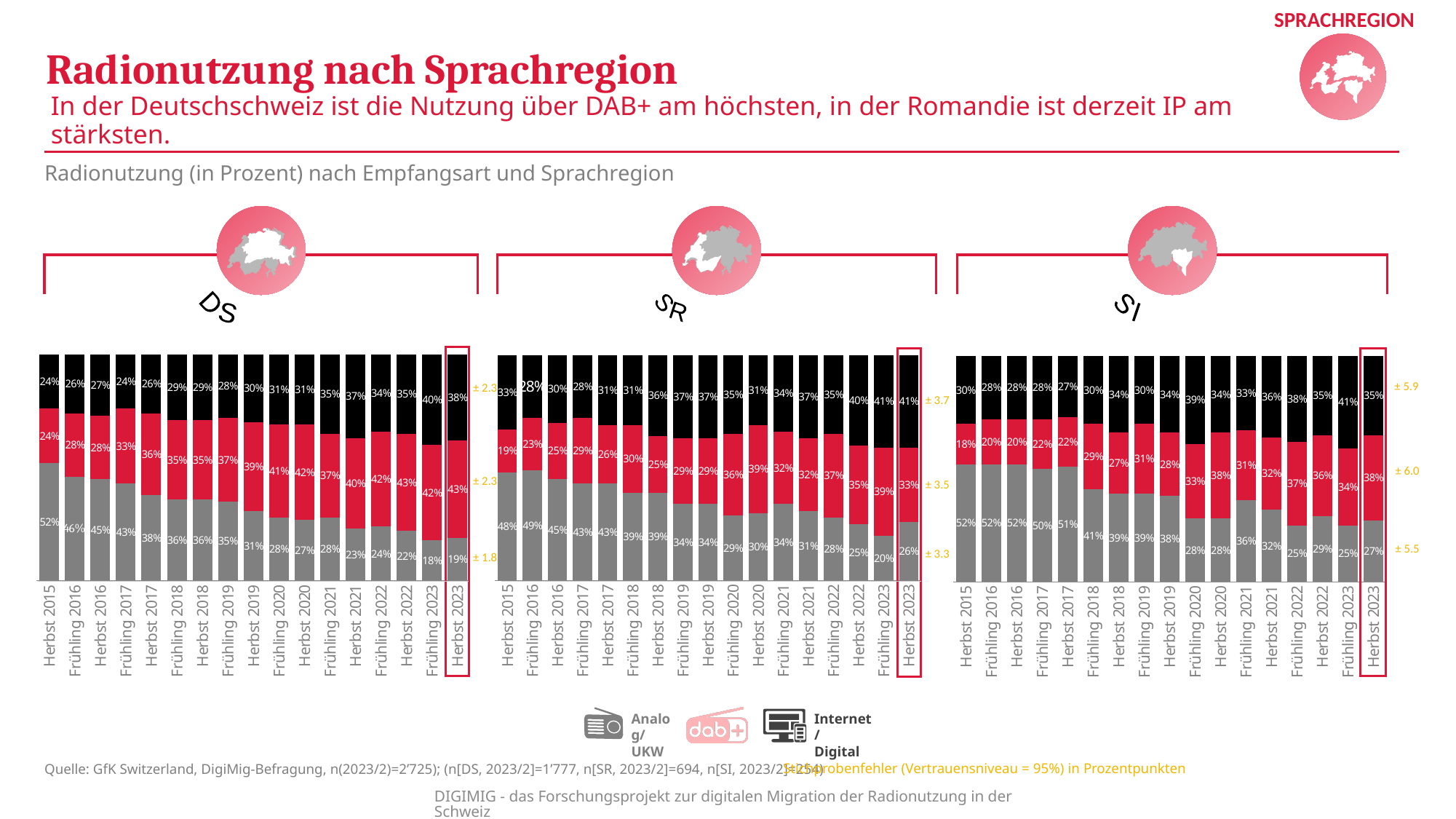
In the SR chart, what is the Internet/Digital (black) share for Herbst 2023? 41% In the DS chart, does the Analog/UKW (grey) share generally rise or fall from Herbst 2015 to Herbst 2023? Fall In the SI chart, which is larger for Herbst 2023: the DAB+ (red) share or the Internet/Digital (black) share? DAB+ (red), 38% In the DS chart, what is the Analog/UKW (grey) share for Herbst 2023? 19% How many reception types (series) does the legend list? 3 What are the three language regions shown above the charts? DS, SR, SI In the SR chart, which period has the lowest Analog/UKW (grey) share? Frühling 2023 In the DS chart, what is the difference between the Analog/UKW share in Herbst 2015 and in Herbst 2023? 33 percentage points In the SI chart, what is the DAB+ (red) share for Herbst 2023? 38% What kind of chart is used for each language region? Stacked bar chart In the DS chart, which period has the highest Analog/UKW (grey) share? Herbst 2015 How many periods (bars) are shown in each of the three charts? 17